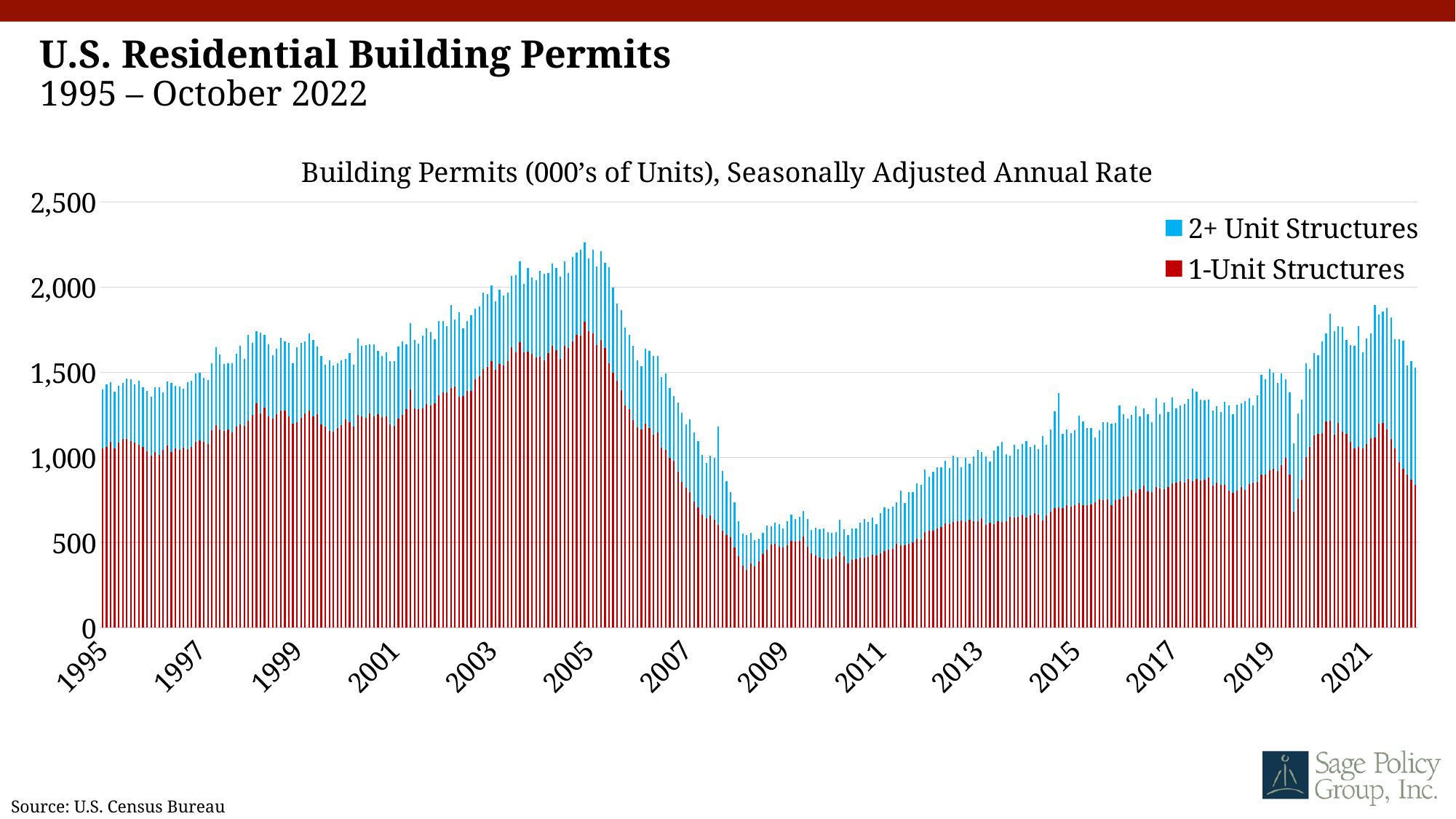
Do total building permits rise or fall between 2011 and 2021? rise Is the peak total of building permits in 2005 greater or less than 2,000? greater Is the total of building permits in 2021 greater or less than 1,500? greater Do total building permits rise or fall between 2006 and 2009? fall In which year do total building permits reach their highest level? 2005 What is the chart's title? Building Permits (000's of Units), Seasonally Adjusted Annual Rate In which year do total building permits reach their lowest level? 2009 What kind of chart is shown on the slide? stacked bar chart What are the two series named in the legend? 2+ Unit Structures and 1-Unit Structures Is the total of building permits in 2009 greater or less than 1,000? less How many series does the legend list? 2